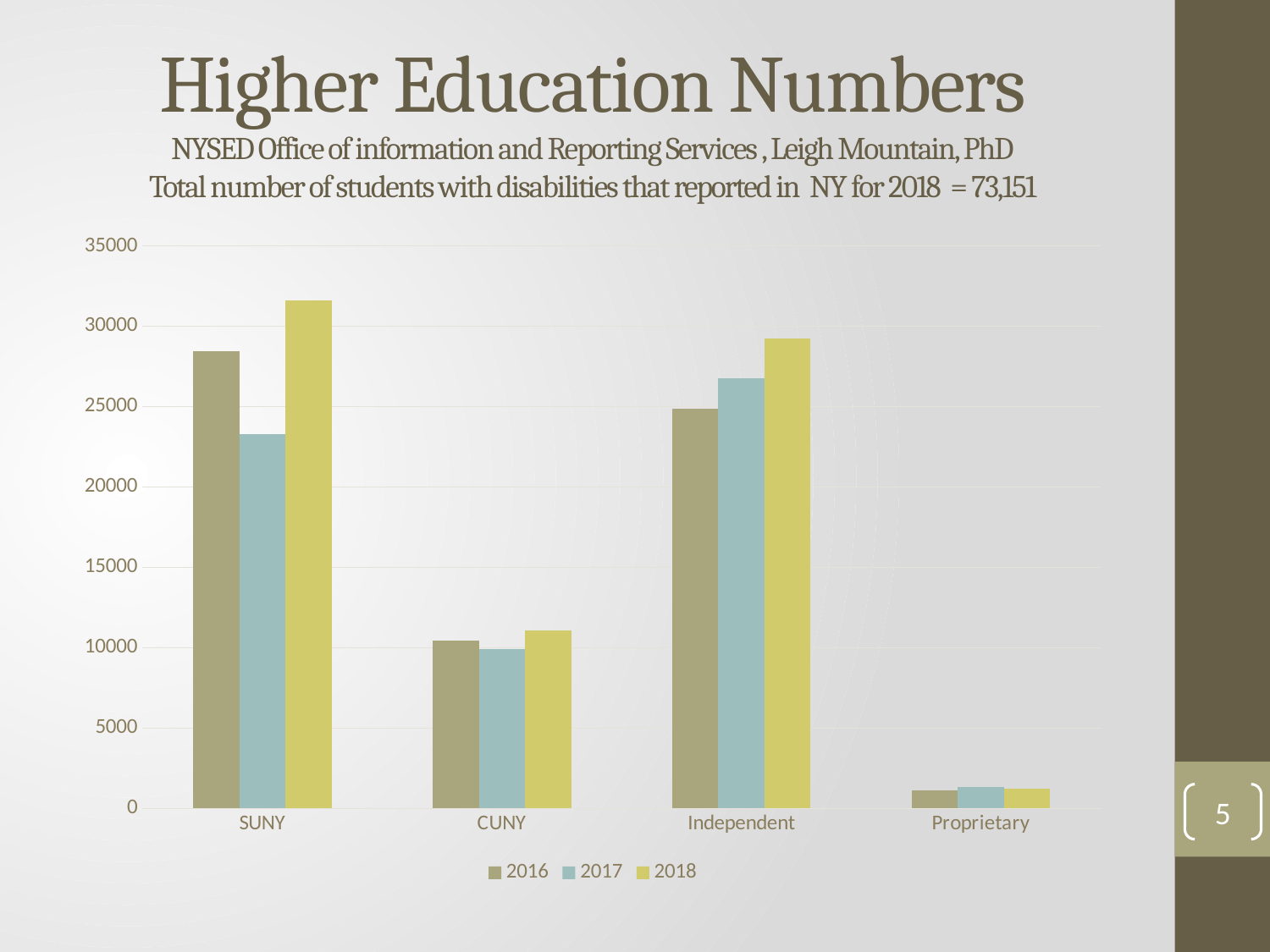
Is the 2017 value for SUNY greater or less than 25000? less Which is larger for SUNY, the 2016 value or the 2017 value? 2016 How many series does the chart's legend list? 3 Is the 2018 value for SUNY greater or less than 30000? greater Which category has the highest 2018 value? SUNY Which category has the lowest values across all three years? Proprietary How many categories are shown on the x axis of the chart? 4 What kind of chart is shown on the slide? bar chart Do the values for Independent rise or fall from 2016 to 2018? rise Which series is shown in yellow in the legend? 2018